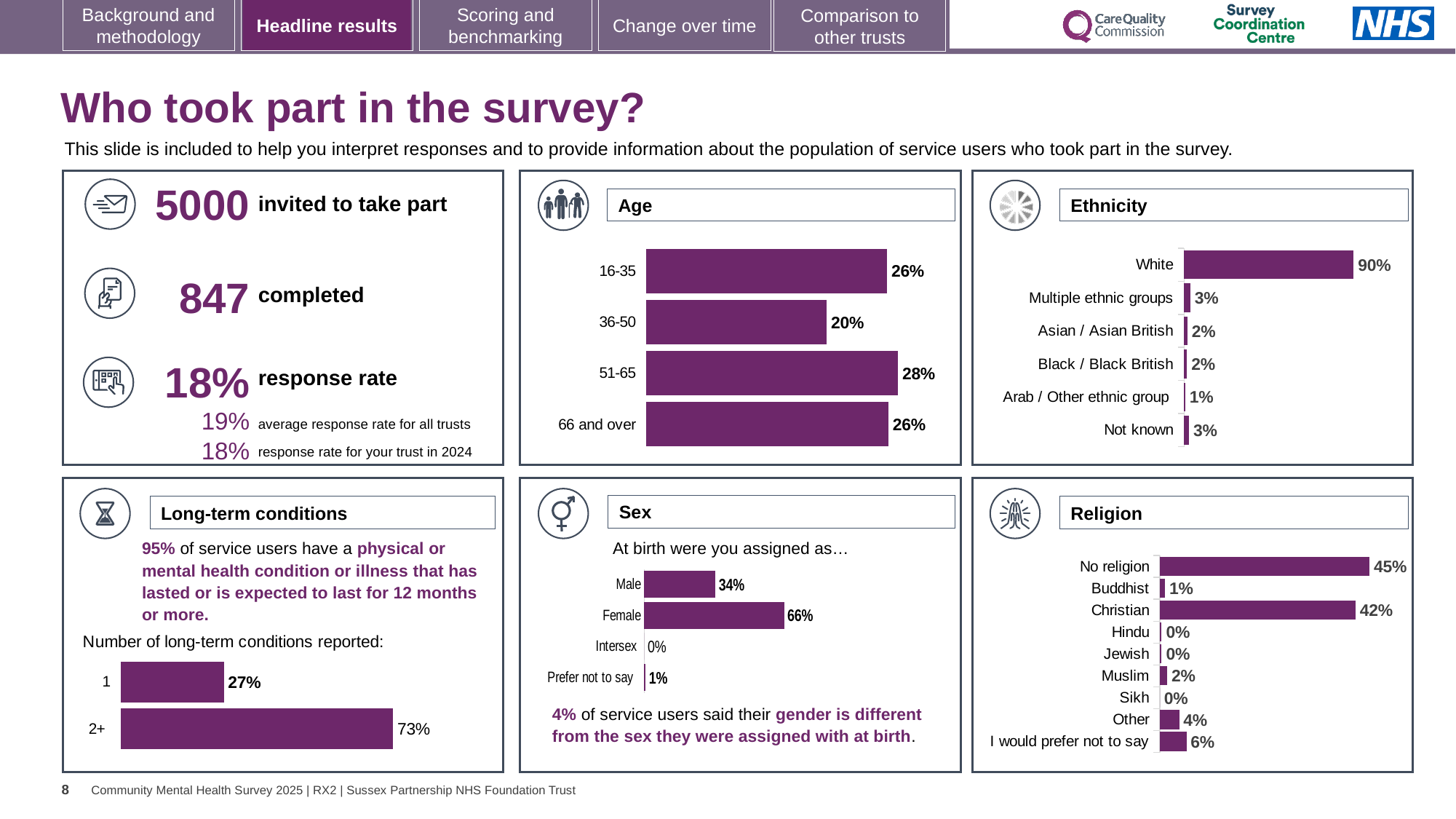
In the Sex chart, what is the difference between the Female and Male percentages? 32% In the Sex chart, what percentage of respondents were assigned Female at birth? 66% In the Age chart, which age group has the highest percentage? 51-65 In the Long-term conditions chart, what percentage of service users reported 2+ long-term conditions? 73% In the Ethnicity chart, what percentage of respondents were White? 90% In the Ethnicity chart, which category has the lowest percentage? Arab / Other ethnic group In the Religion chart, is the value for Christian larger or smaller than the value for No religion? smaller In the Religion chart, which religion category has the highest percentage? No religion What type of chart is used in the Age panel? bar chart In the Age chart, what percentage of respondents were aged 36-50? 20% In the Age chart, how many age categories are shown? 4 In the Ethnicity chart, what is the difference between the White and Not known percentages? 87%